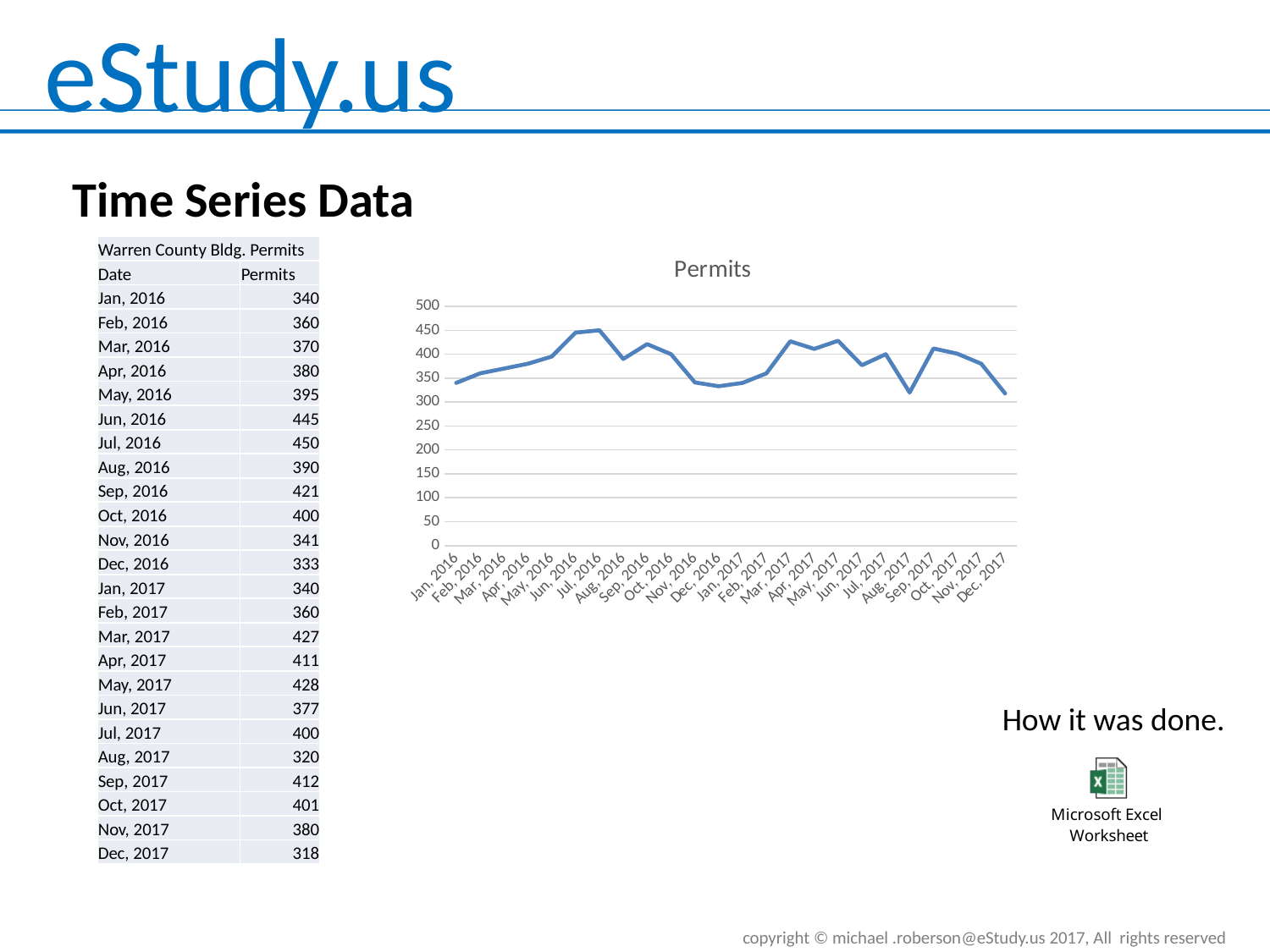
What is the number of permits for Jul, 2016? 450 Is the value for Dec, 2016 greater or less than 350? less Which month has the lowest number of permits in the chart? Dec, 2017 What is the number of permits for Sep, 2016? 421 Which has more permits, Jun, 2016 or Jun, 2017? Jun, 2016 How many monthly data points are plotted in the Permits chart? 24 What is the difference in permits between Jul, 2016 and Aug, 2016? 60 What is the number of permits for Dec, 2017? 318 Do the permit values rise or fall from Jan, 2016 to Jul, 2016? rise What is the title of the chart? Permits Which month has the highest number of permits in the chart? Jul, 2016 What type of chart is shown on the slide? line chart